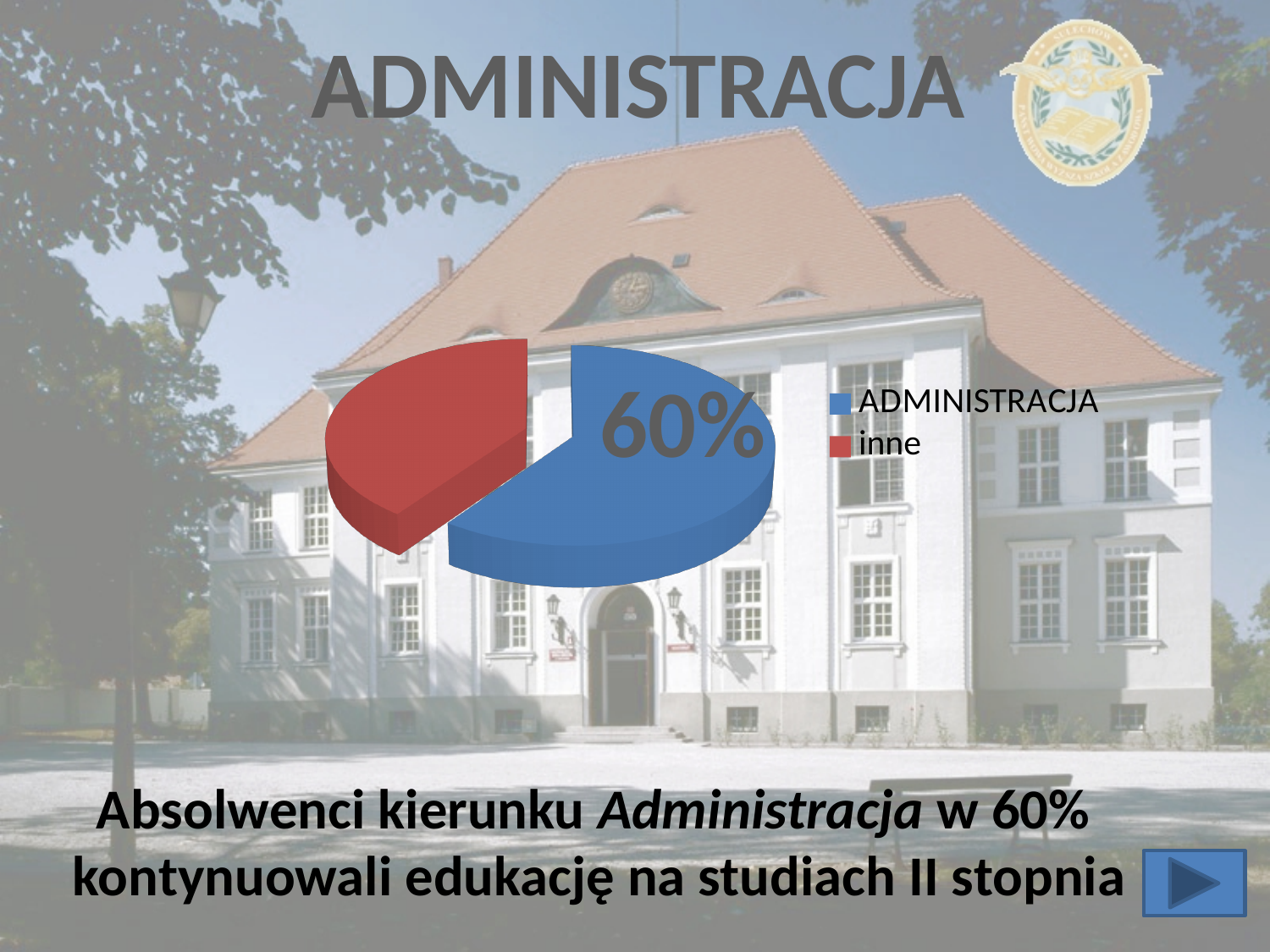
Which slice of the pie chart is the smallest? inne What share of the pie does the ADMINISTRACJA slice represent? 60% How many entries does the chart legend list? 2 What is the title shown at the top of the slide? ADMINISTRACJA What colour is the ADMINISTRACJA slice in the pie chart? blue Which is larger, the ADMINISTRACJA slice or the inne slice? ADMINISTRACJA What kind of chart is shown on the slide? pie chart What value is printed on the blue slice of the pie chart? 60% How many slices does the pie chart have? 2 Which slice of the pie chart is the largest? ADMINISTRACJA